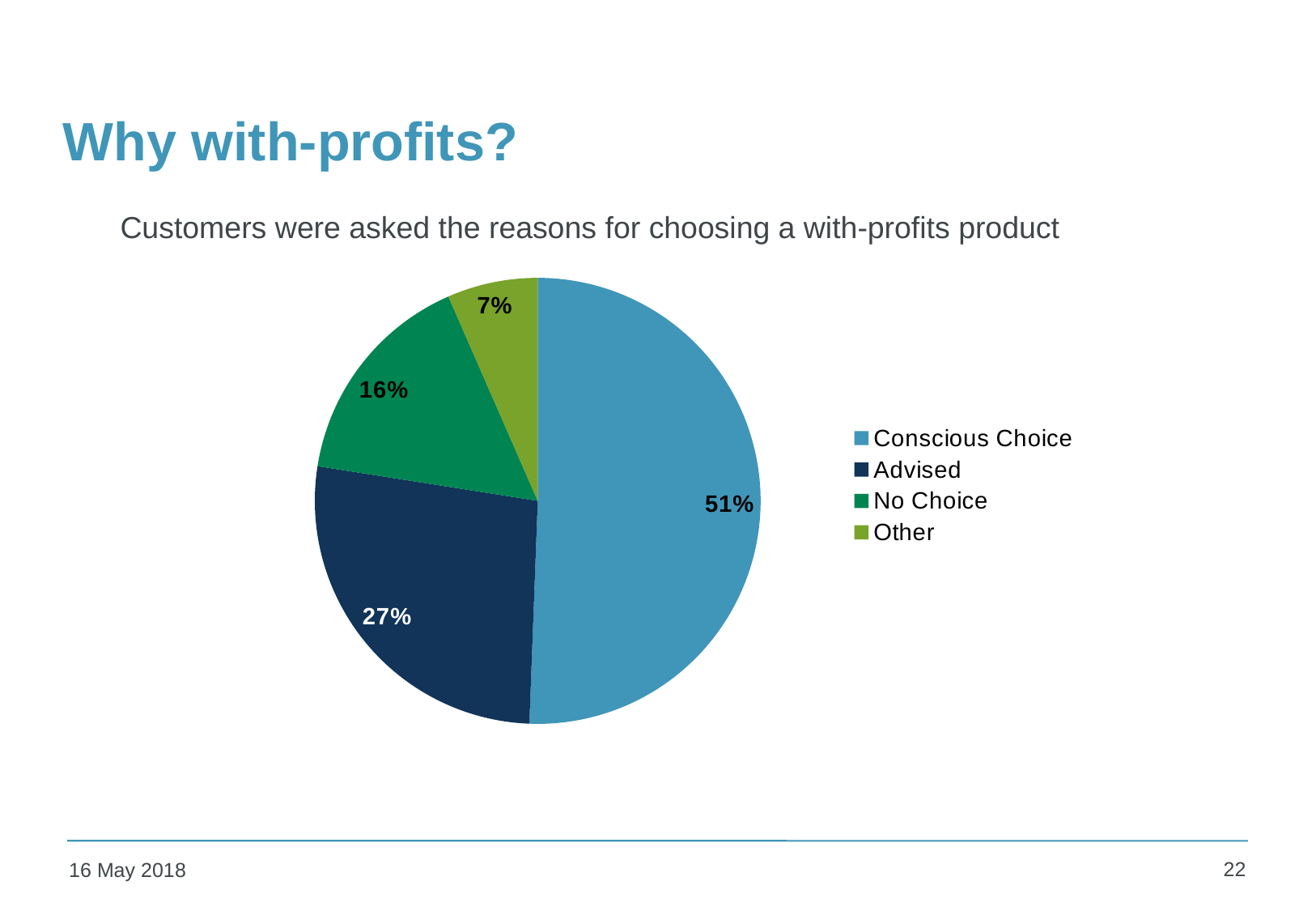
Which category has the largest slice of the pie? Conscious Choice What share of the pie is No Choice? 16% What is the difference in percentage points between Conscious Choice and Advised? 24 What kind of chart is shown on the slide? pie chart How many entries does the legend list? 4 What share of the pie is Conscious Choice? 51% Which legend entry is shown in the darkest blue colour? Advised Which is larger, the share for No Choice or the share for Other? No Choice What share of the pie is Advised? 27% What share of the pie is Other? 7% How many categories does the pie chart show? 4 Which category has the smallest slice of the pie? Other